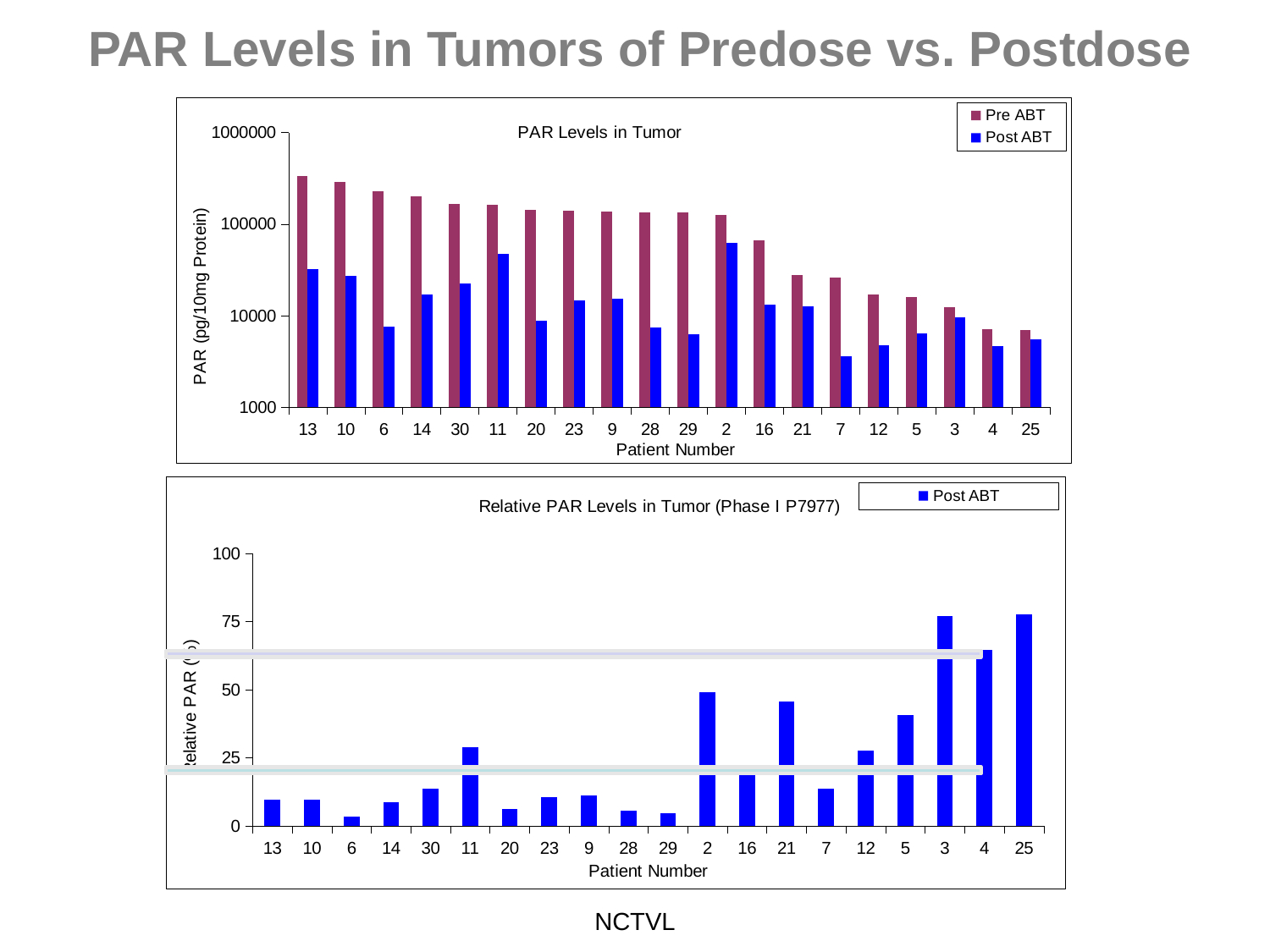
In the bottom chart "Relative PAR Levels in Tumor (Phase I P7977)", how many series does the legend list? 1 In the bottom chart "Relative PAR Levels in Tumor (Phase I P7977)", is the value for patient 5 greater or less than 25? greater In the top chart "PAR Levels in Tumor", is the Pre ABT value for patient 13 greater or less than 100000? greater In the top chart "PAR Levels in Tumor", do the Pre ABT values rise or fall from left to right along the x axis? fall In the bottom chart "Relative PAR Levels in Tumor (Phase I P7977)", which patient has the lowest value? 6 In the top chart "PAR Levels in Tumor", is the Post ABT value for patient 6 greater or less than 10000? less What kind of chart is the top chart titled "PAR Levels in Tumor"? bar chart In the top chart "PAR Levels in Tumor", for patient 13, which is larger: the Pre ABT value or the Post ABT value? Pre ABT In the top chart "PAR Levels in Tumor", how many series does the legend list? 2 In the top chart "PAR Levels in Tumor", which patient has the highest Post ABT value? 2 In the top chart "PAR Levels in Tumor", how many patient numbers are shown on the x axis? 20 In the top chart "PAR Levels in Tumor", which patient has the highest Pre ABT value? 13